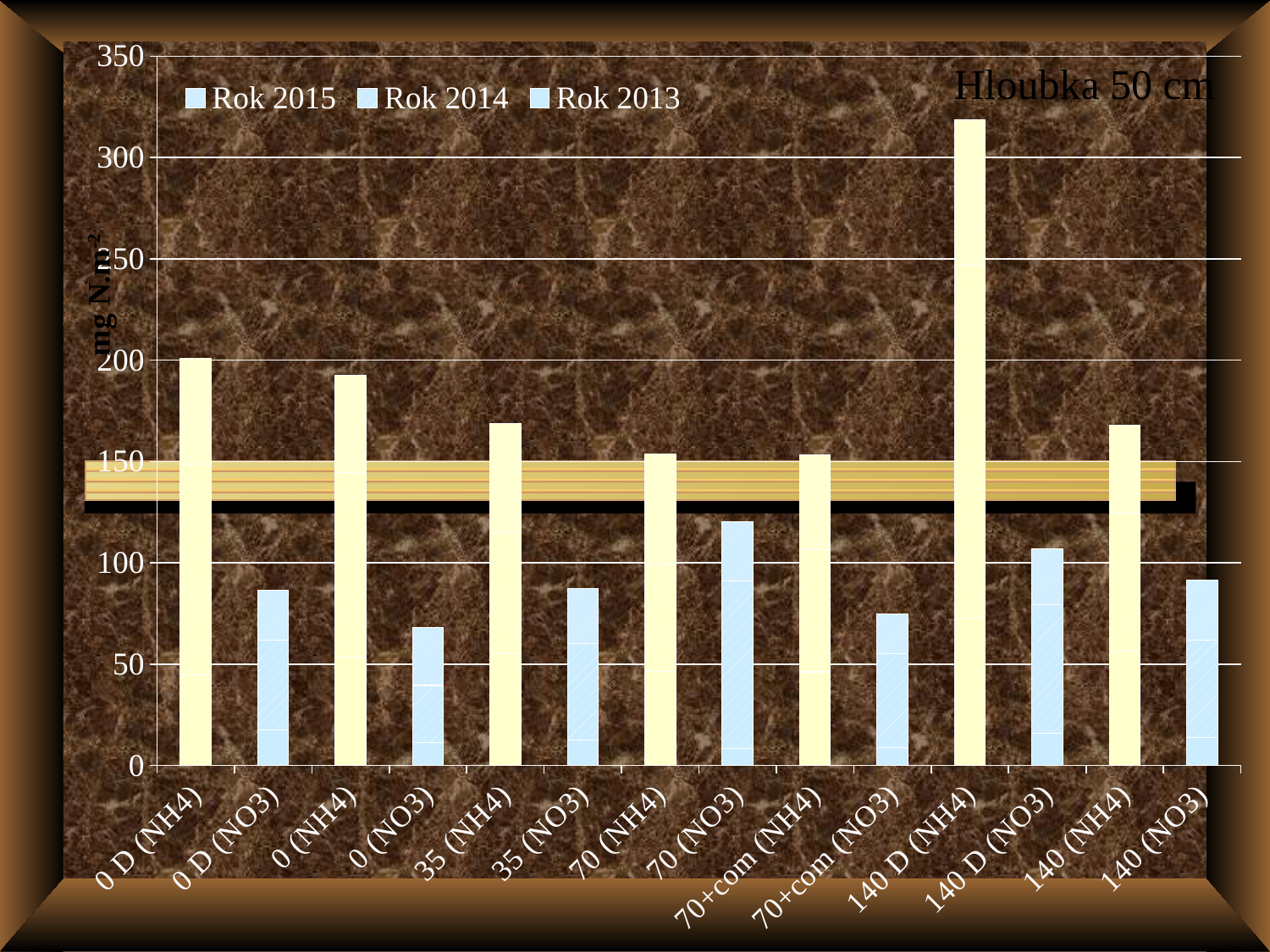
Is the total value for 140 D (NH4) greater or less than 300? greater Is the total value for 0 D (NH4) greater or less than 150? greater What are the three legend entries of the chart? Rok 2015, Rok 2014, Rok 2013 What kind of chart is shown on the slide? Stacked bar chart Is the total value for 70 (NO3) greater or less than 100? greater What is the title shown in the top right of the chart? Hloubka 50 cm How many categories are shown along the x axis? 14 Which category has the highest total bar? 140 D (NH4) Which has the larger total bar, 70 (NO3) or 70+com (NO3)? 70 (NO3) Which has the larger total bar, 0 D (NH4) or 0 D (NO3)? 0 D (NH4) How many series does the legend list? 3